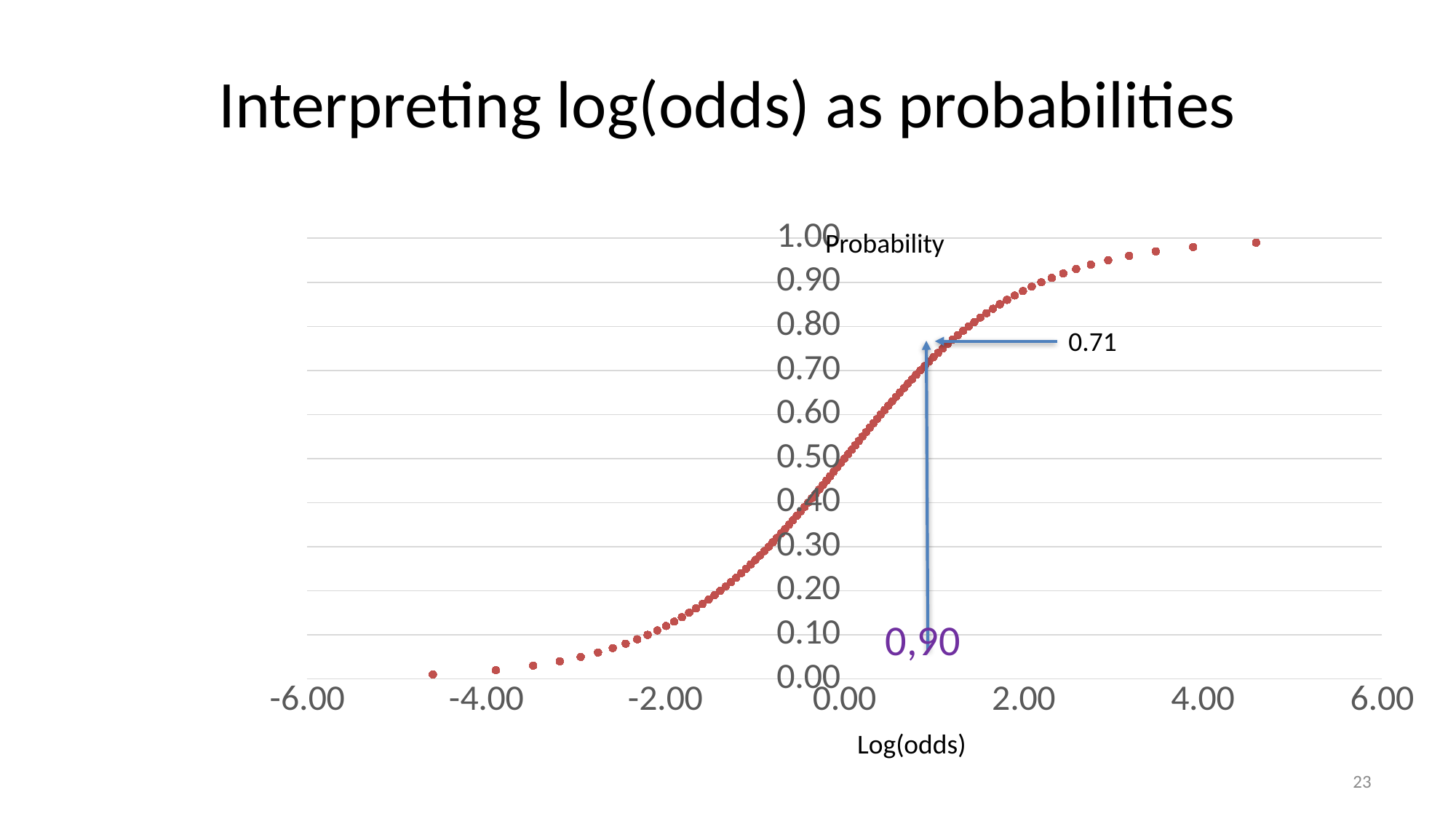
What is the highest value shown on the y axis of the chart? 1.00 Is the probability at a log(odds) of 4.00 greater or less than 0.90? greater According to the annotation on the chart, what is the probability at a log(odds) value of 0,90? 0.71 Is the probability at a log(odds) of -2.00 greater or less than 0.20? less Is the probability at a log(odds) of 0.00 greater or less than 0.40? greater What kind of chart is shown on the slide? scatter chart What is the label of the x axis of the chart? Log(odds) Do the probability values rise or fall as log(odds) increases along the x axis? rise What is the title of the slide containing the chart? Interpreting log(odds) as probabilities Which has the higher probability: the point at log(odds) -2.00 or the point at log(odds) 2.00? 2.00